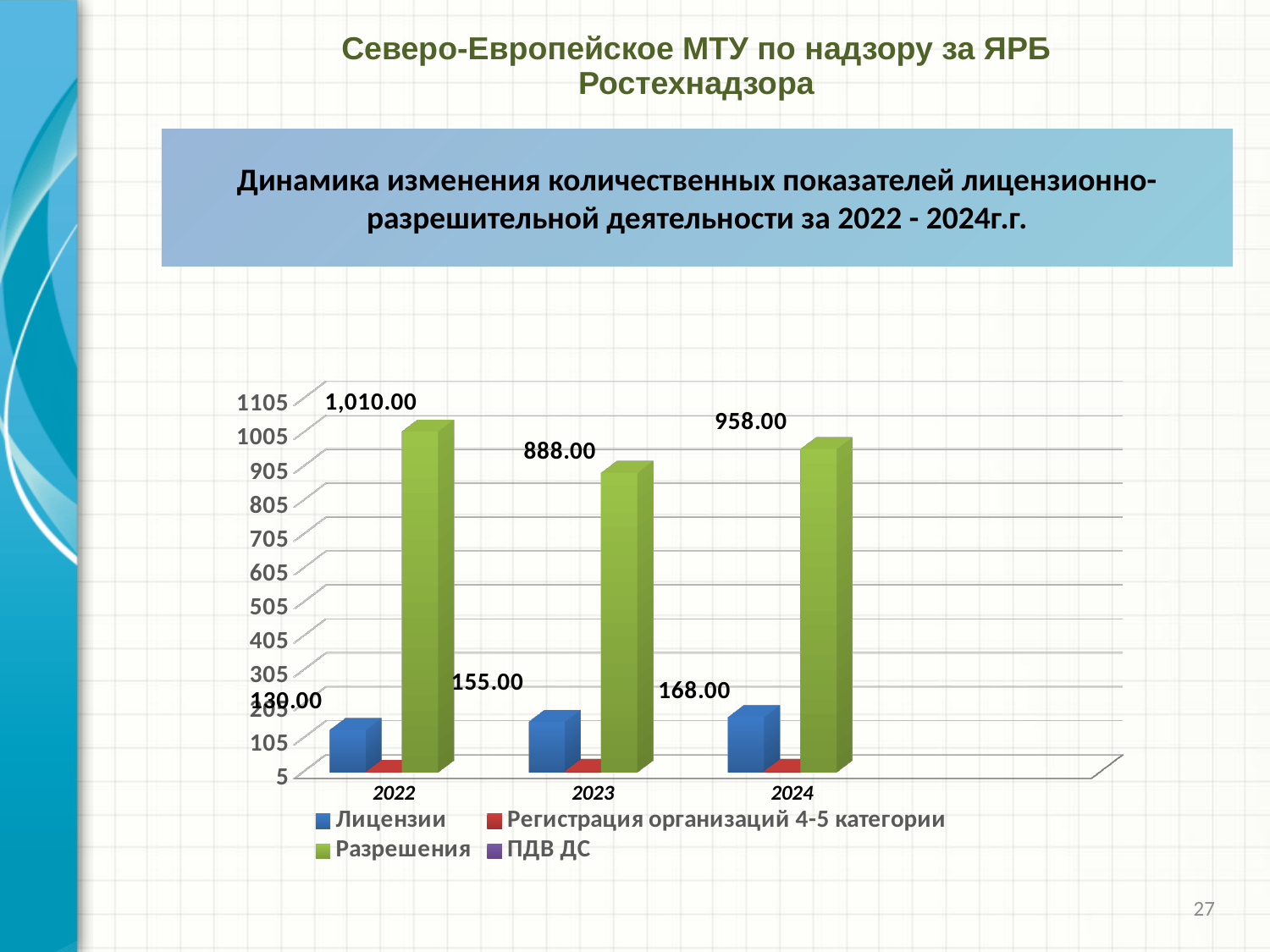
What is the value of Лицензии for 2023? 155.00 What is the value of Разрешения for 2022? 1,010.00 What is the difference between the Разрешения values for 2022 and 2023? 122.00 How many series does the legend list? 4 In which year is the value of Разрешения the lowest? 2023 What is the value of Лицензии for 2024? 168.00 Which year has the larger Разрешения value, 2023 or 2024? 2024 What is the value of Разрешения for 2024? 958.00 In which year is the value of Разрешения the highest? 2022 Is the value of Лицензии for 2022 greater or less than 305? less What is the value of Разрешения for 2023? 888.00 How many years are shown on the x axis? 3